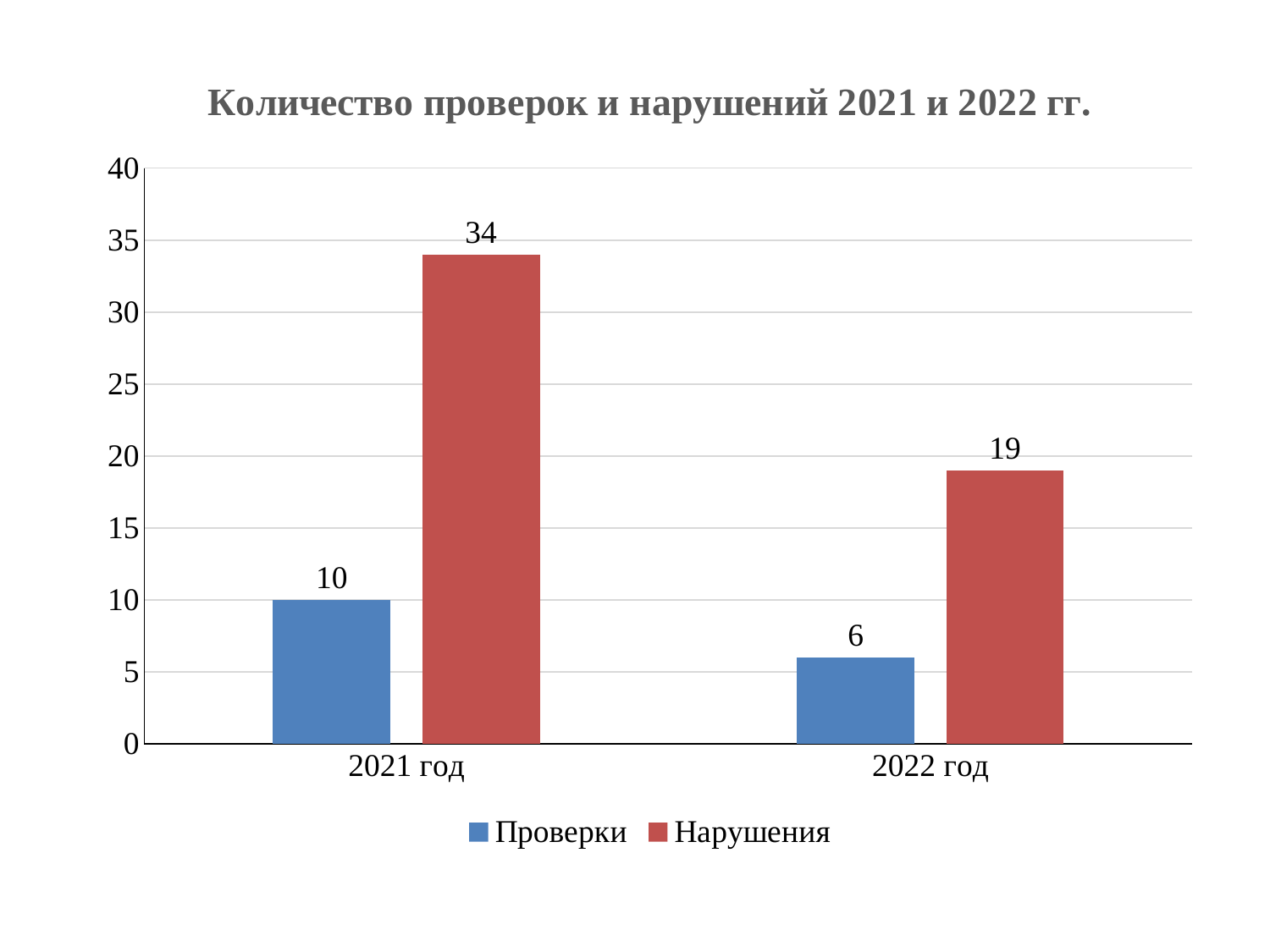
Which year has the lowest value for Проверки? 2022 год How many categories are shown on the x axis? 2 How many series does the legend list? 2 What is the value of Нарушения for 2022 год? 19 Do the values for Проверки rise or fall from 2021 год to 2022 год? fall What is the value of Проверки for 2021 год? 10 What is the value of Нарушения for 2021 год? 34 Which is larger in 2021 год: Проверки or Нарушения? Нарушения Which year has the higher value for Нарушения? 2021 год What is the difference between Проверки and Нарушения in 2022 год? 13 What kind of chart is shown on the slide? bar chart What is the difference between Нарушения in 2021 год and 2022 год? 15